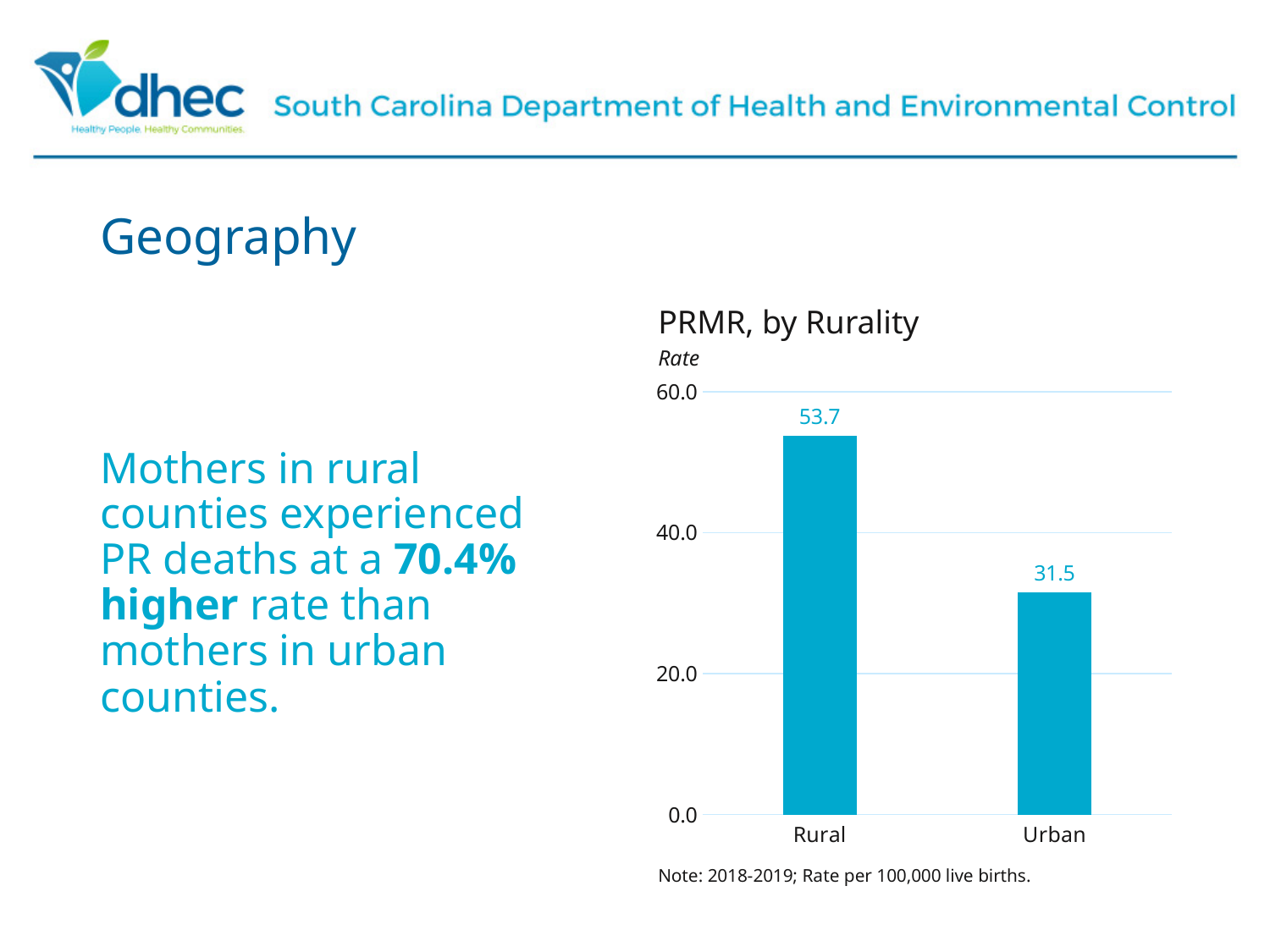
Is the value for Rural greater or less than 40.0? greater How many categories are shown on the x axis of the chart? 2 What is the PRMR for Urban counties? 31.5 Which category has the highest PRMR? Rural Which is larger, the PRMR for Rural or for Urban? Rural What is the difference between the Rural and Urban PRMR values? 22.2 What is the title of the chart? PRMR, by Rurality What is the PRMR for Rural counties? 53.7 Which category has the lowest PRMR? Urban What is the label on the vertical axis of the chart? Rate What kind of chart is shown on the slide? Bar chart Is the value for Urban greater or less than 40.0? less